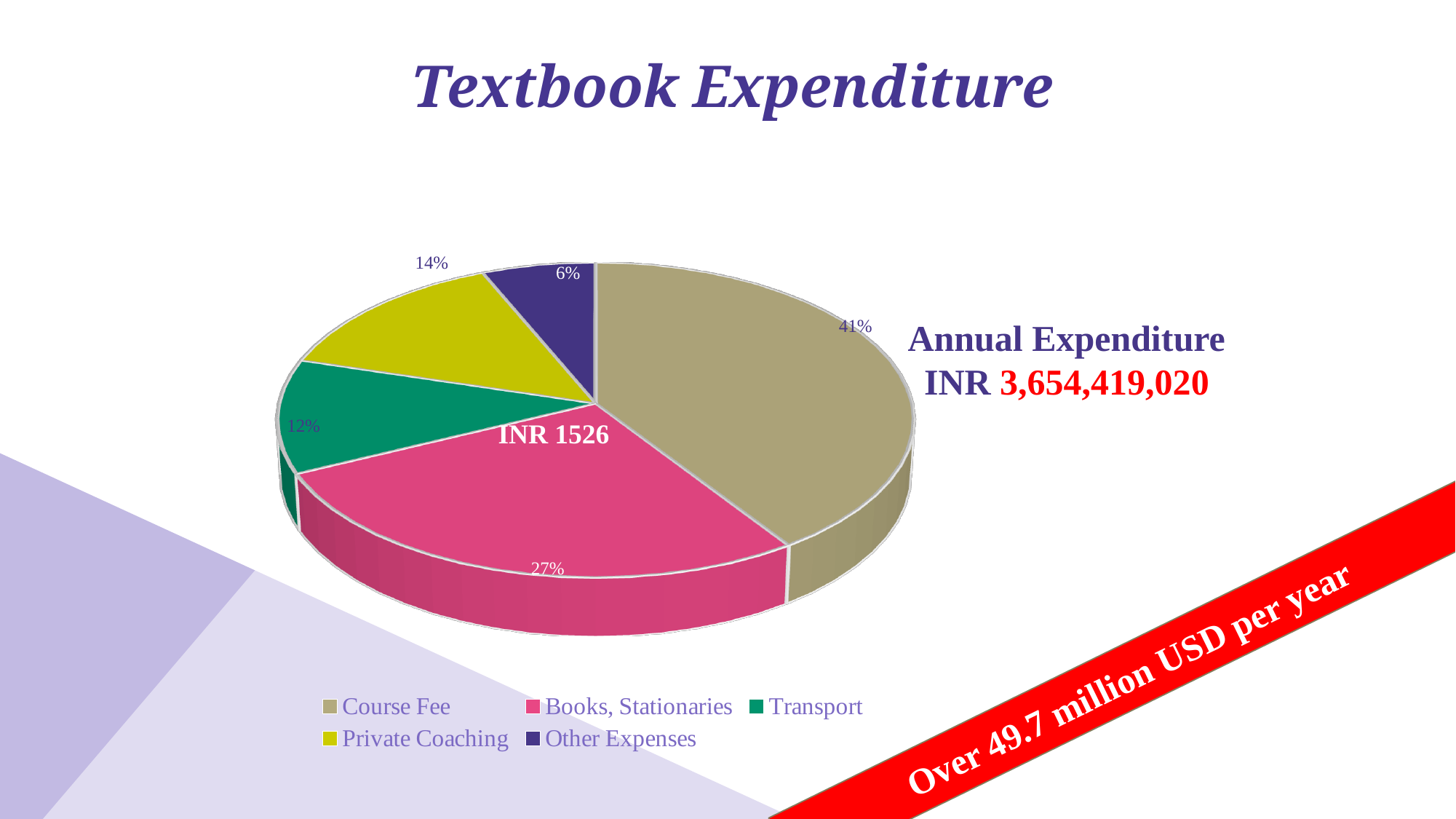
How many categories are shown in the pie chart? 5 What is the title of the slide containing the pie chart? Textbook Expenditure What is the difference in percentage points between Course Fee and Books, Stationaries? 14 Which is larger, the share for Private Coaching or the share for Transport? Private Coaching Which category has the smallest slice of the pie? Other Expenses What share of the pie does Books, Stationaries take? 27% What share of the pie does Other Expenses take? 6% Which category has the largest slice of the pie? Course Fee What share of the pie does Private Coaching take? 14% What kind of chart is shown on the slide? Pie chart